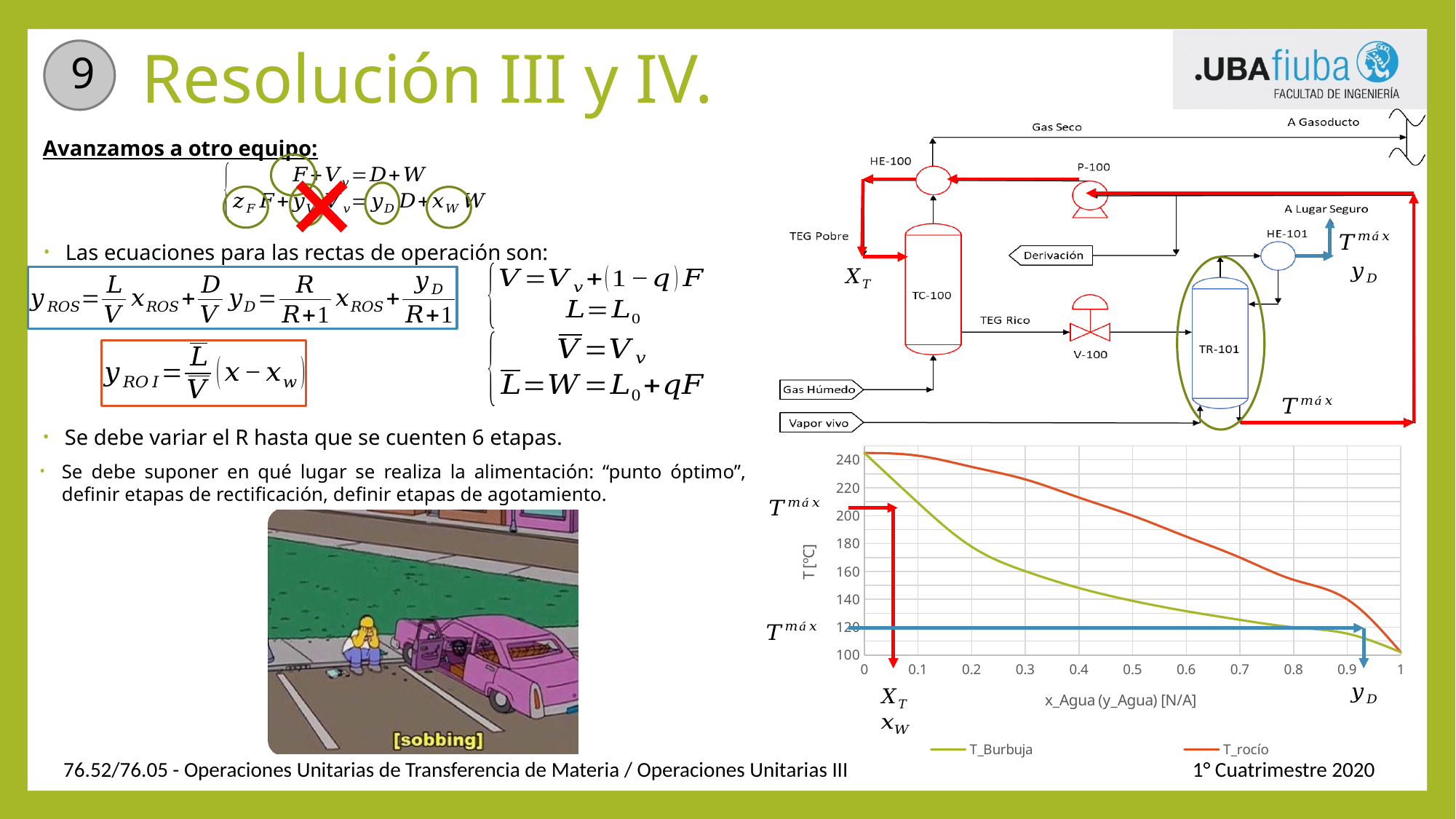
In the temperature chart, is the T_rocío value at x_Agua = 0.5 greater or less than 180? greater In the temperature chart, is the T_rocío value at x_Agua = 0.3 greater or less than 200? greater How many series does the legend of the T [°C] vs x_Agua chart list? 2 In the temperature chart, do the T_rocío values rise or fall as x_Agua increases? fall In the temperature chart, do the T_Burbuja values rise or fall as x_Agua increases? fall What kind of chart is shown at the bottom right of the slide? line chart What is the label of the vertical axis of the temperature chart? T [°C] What are the two series named in the legend of the temperature chart? T_Burbuja and T_rocío In the temperature chart, is the T_rocío value at x_Agua = 0.8 greater or less than 140? greater In the temperature chart, at x_Agua = 0.5, which series has the higher temperature, T_Burbuja or T_rocío? T_rocío